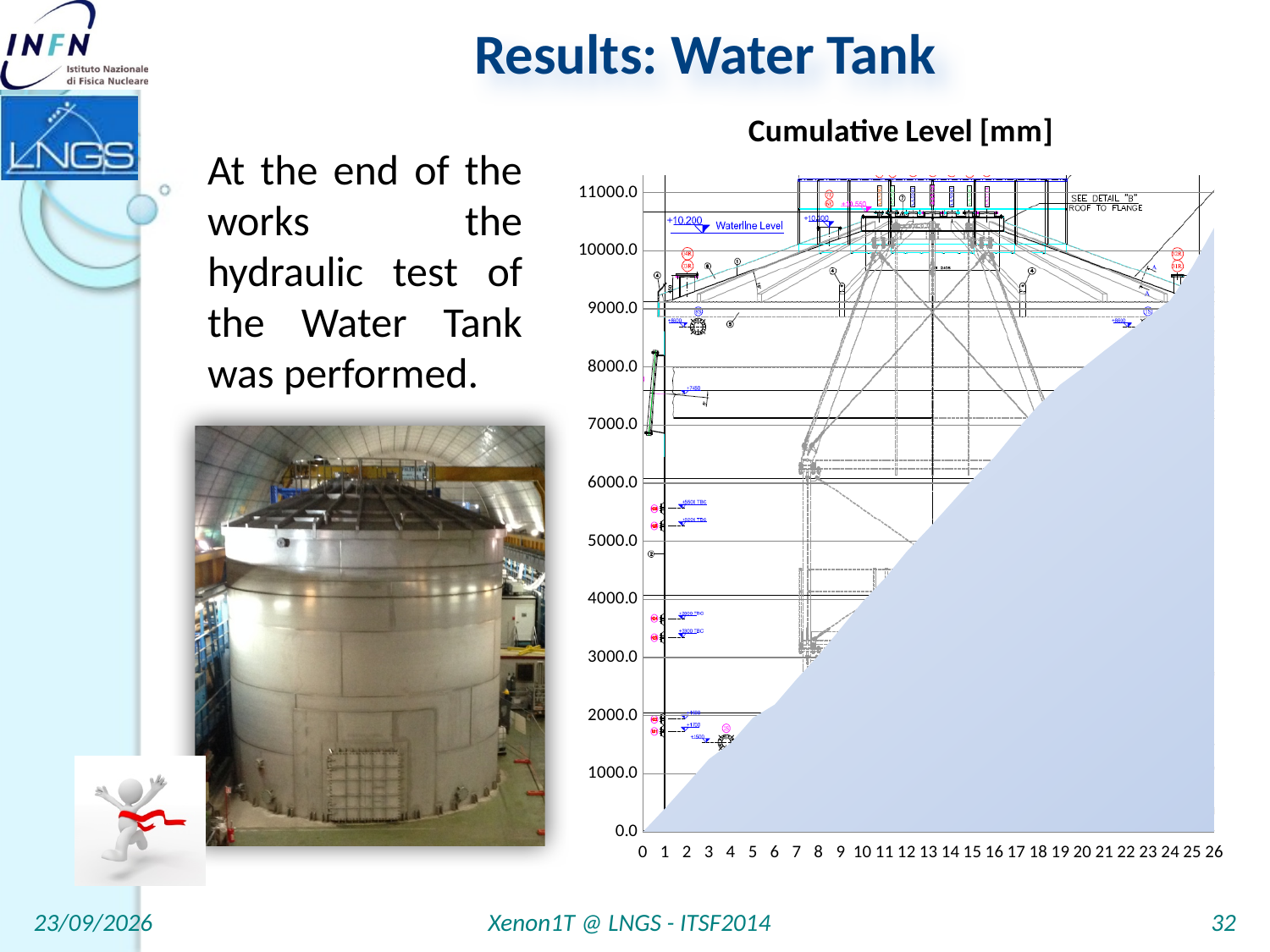
How many tick labels are shown on the x-axis? 27 At which x-axis value is the cumulative level lowest? 0 Is the cumulative level at x = 26 greater or less than 10000? greater Is the cumulative level at x = 8 greater or less than 4000? less Which has the larger cumulative level, x = 10 or x = 22? x = 22 Is the cumulative level at x = 20 greater or less than 6000? greater What kind of chart is shown on the slide? area chart What is the title of the chart? Cumulative Level [mm] Does the cumulative level rise or fall as the x-axis value increases from 0 to 26? rise What is the highest tick label shown on the y-axis? 11000.0 At which x-axis value is the cumulative level highest? 26